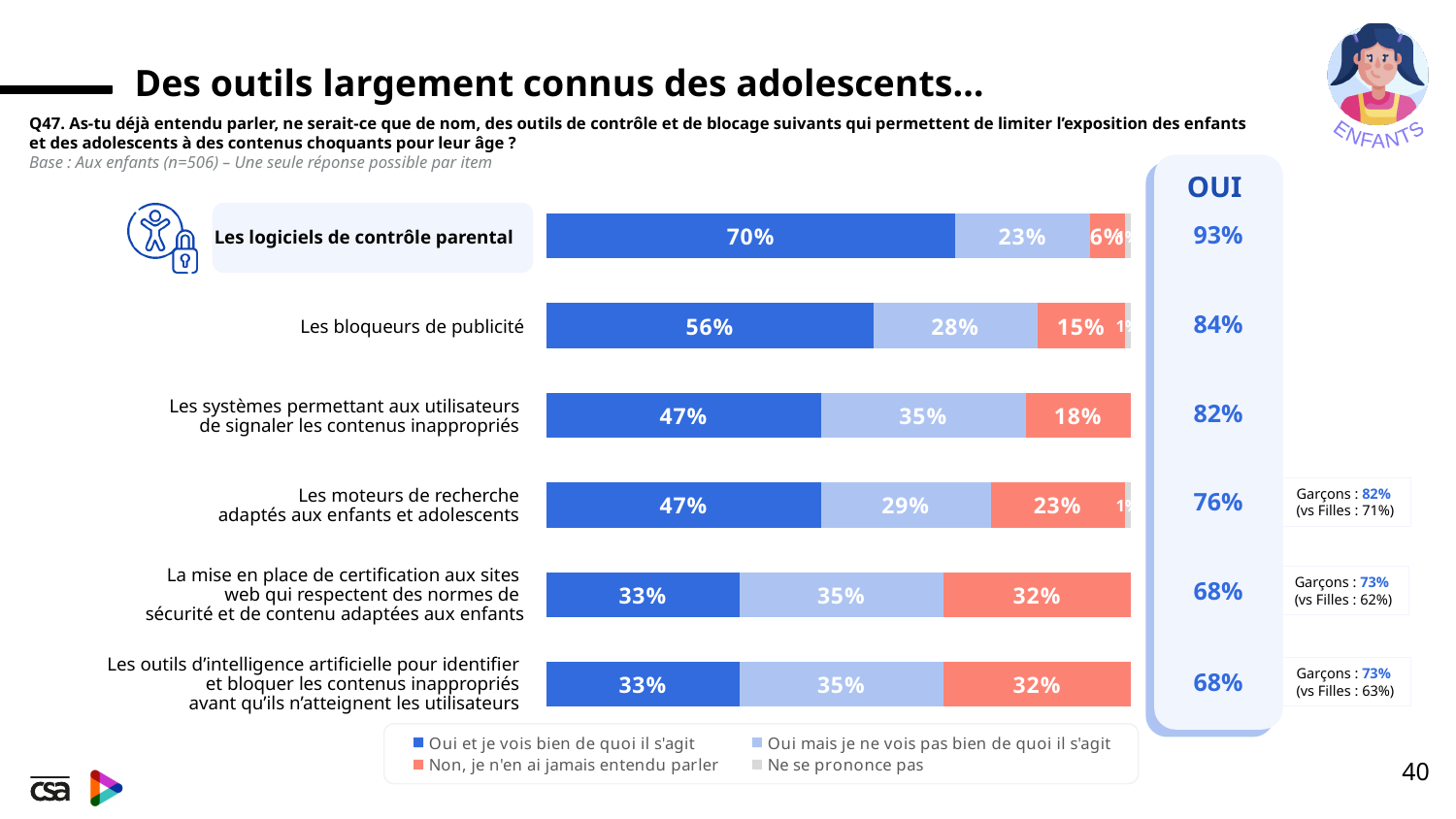
What is the value of "Non, je n'en ai jamais entendu parler" for "Les bloqueurs de publicité"? 15% What kind of chart is shown on the slide? Stacked bar chart Which category has the highest value for "Oui et je vois bien de quoi il s'agit"? Les logiciels de contrôle parental Which colour represents "Non, je n'en ai jamais entendu parler" in the chart? Salmon/red What is the value of "Oui et je vois bien de quoi il s'agit" for "Les logiciels de contrôle parental"? 70% How many tools (categories) are plotted in the chart? 6 Which is larger: the "Non, je n'en ai jamais entendu parler" value for "Les moteurs de recherche adaptés aux enfants et adolescents" or for "Les systèmes permettant aux utilisateurs de signaler les contenus inappropriés"? Les moteurs de recherche adaptés aux enfants et adolescents (23%) What is the "OUI" total shown for "Les moteurs de recherche adaptés aux enfants et adolescents"? 76% What is the difference between the "Oui et je vois bien de quoi il s'agit" values for "Les logiciels de contrôle parental" and "Les bloqueurs de publicité"? 14 percentage points What is the value of "Oui mais je ne vois pas bien de quoi il s'agit" for "Les systèmes permettant aux utilisateurs de signaler les contenus inappropriés"? 35% How many series does the legend list? 4